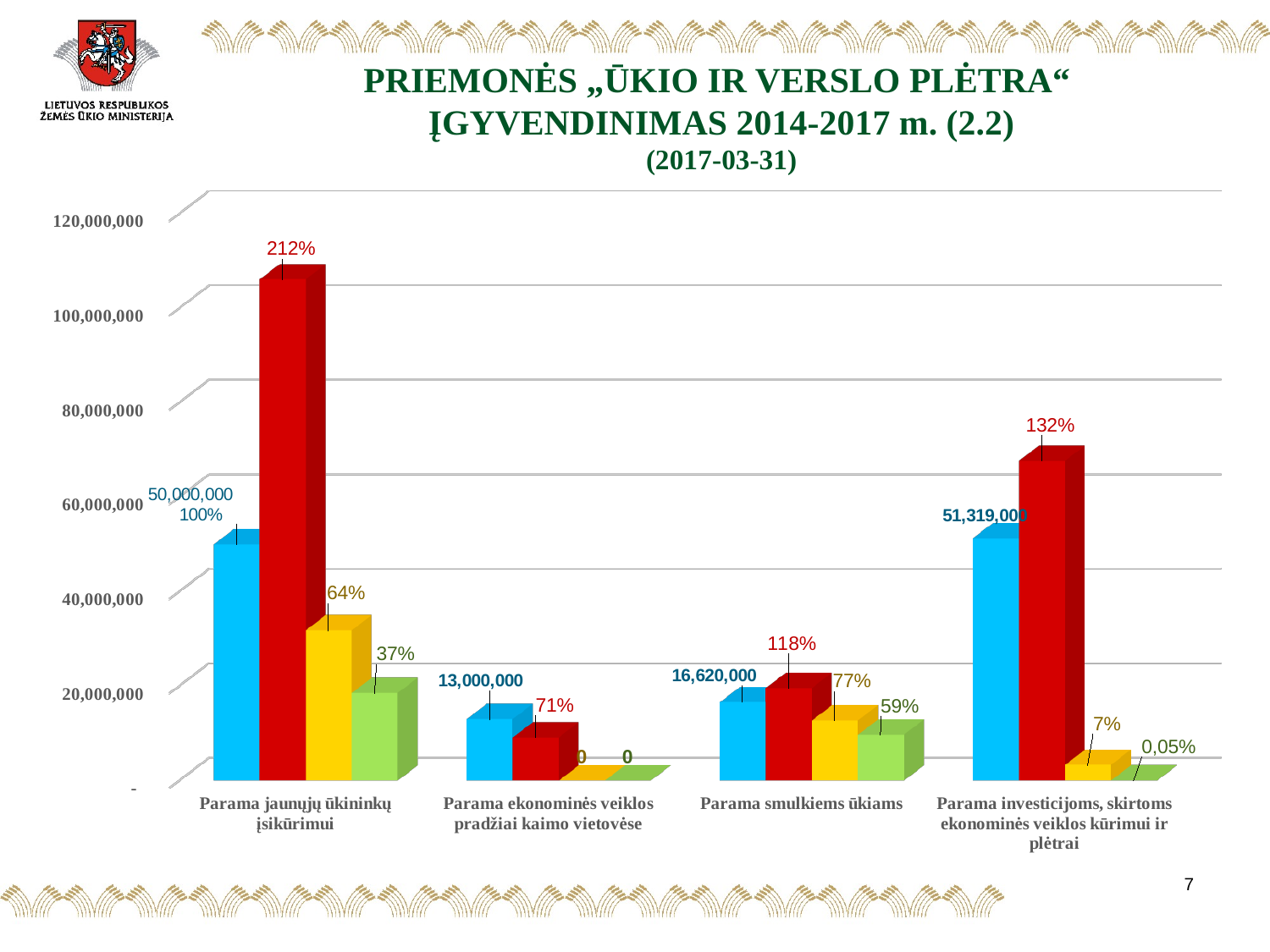
Which is larger: the red bar for "Parama jaunųjų ūkininkų įsikūrimui" or the red bar for "Parama investicijoms, skirtoms ekonominės veiklos kūrimui ir plėtrai"? Parama jaunųjų ūkininkų įsikūrimui What is the difference between the blue bar values for "Parama smulkiems ūkiams" and "Parama ekonominės veiklos pradžiai kaimo vietovėse"? 3,620,000 What percentage is labelled on the green bar for "Parama investicijoms, skirtoms ekonominės veiklos kūrimui ir plėtrai"? 0,05% What kind of chart is shown on the slide? bar chart Which category has the lowest labelled value on its blue bar? Parama ekonominės veiklos pradžiai kaimo vietovėse What value is labelled on the blue bar for "Parama smulkiems ūkiams"? 16,620,000 What percentage is labelled on the red bar for "Parama ekonominės veiklos pradžiai kaimo vietovėse"? 71% How many categories are shown on the x axis? 4 Is the red bar for "Parama jaunųjų ūkininkų įsikūrimui" greater or less than 100,000,000? greater What value is labelled on the blue bar for "Parama jaunųjų ūkininkų įsikūrimui"? 50,000,000 What value is labelled on the blue bar for "Parama investicijoms, skirtoms ekonominės veiklos kūrimui ir plėtrai"? 51,319,000 What percentage is labelled on the red bar for "Parama jaunųjų ūkininkų įsikūrimui"? 212%